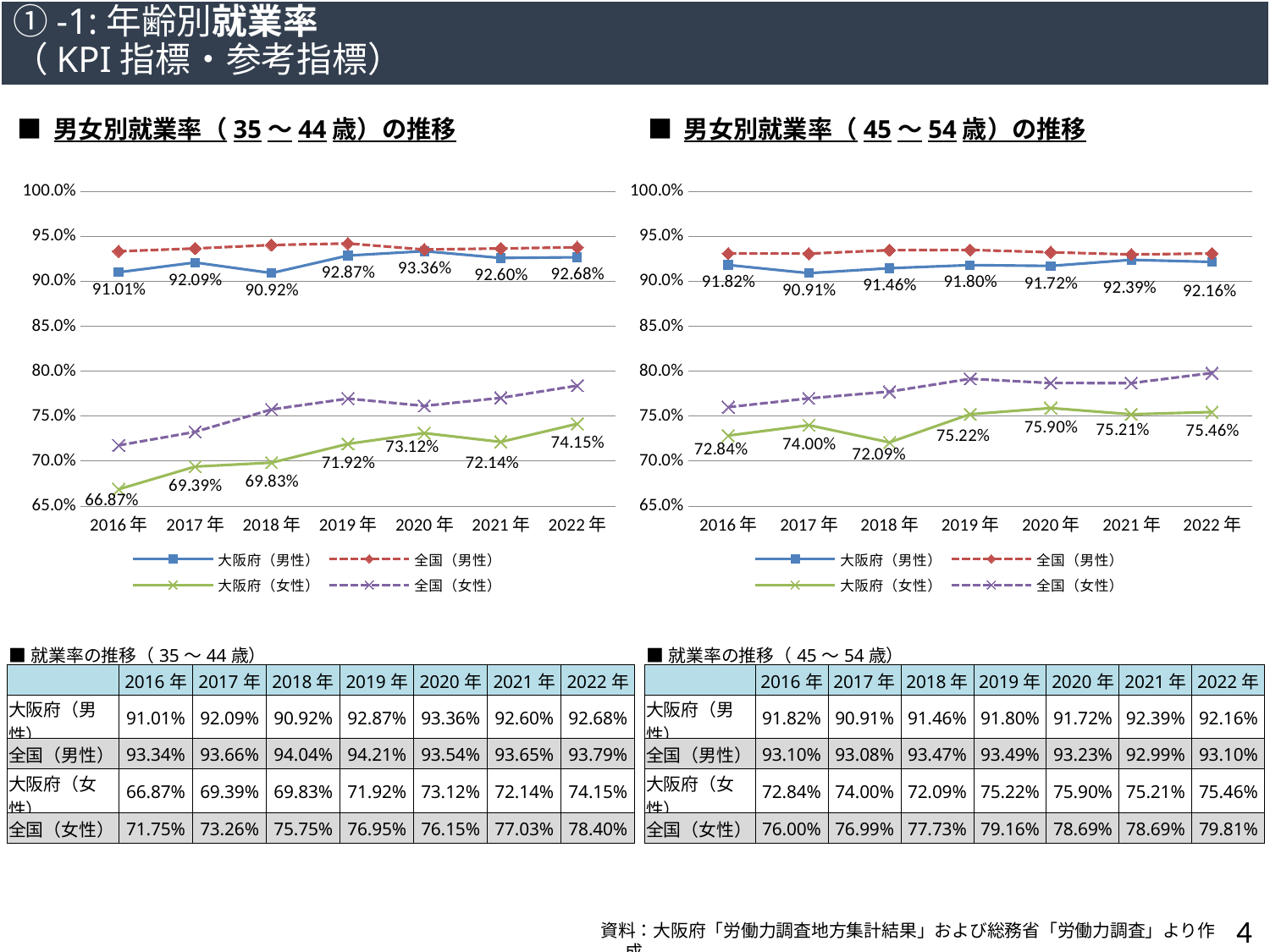
In the left chart (男女別就業率（35～44歳）の推移), what is the value for 大阪府（女性） in 2016年? 66.87% In the left chart (男女別就業率（35～44歳）の推移), is the 全国（女性） value in 2022年 greater or less than 75.0%? greater How many years are plotted on the x axis of the left chart (男女別就業率（35～44歳）の推移)? 7 How many series does the legend of the right chart (男女別就業率（45～54歳）の推移) list? 4 In the right chart (男女別就業率（45～54歳）の推移), what is the value for 大阪府（女性） in 2020年? 75.90% In the left chart (男女別就業率（35～44歳）の推移), in which year is the 大阪府（女性） value lowest? 2016年 In the right chart (男女別就業率（45～54歳）の推移), what is the value for 大阪府（男性） in 2021年? 92.39% In the left chart (男女別就業率（35～44歳）の推移), what is the difference between the 大阪府（女性） values in 2022年 and 2016年? 7.28% In the right chart (男女別就業率（45～54歳）の推移), in which year is the 大阪府（男性） value highest? 2021年 What type of chart is the left chart (男女別就業率（35～44歳）の推移)? line chart In the right chart (男女別就業率（45～54歳）の推移), which is larger, the 大阪府（女性） value in 2019年 or in 2018年? 2019年 In the left chart (男女別就業率（35～44歳）の推移), what is the value for 大阪府（男性） in 2020年? 93.36%